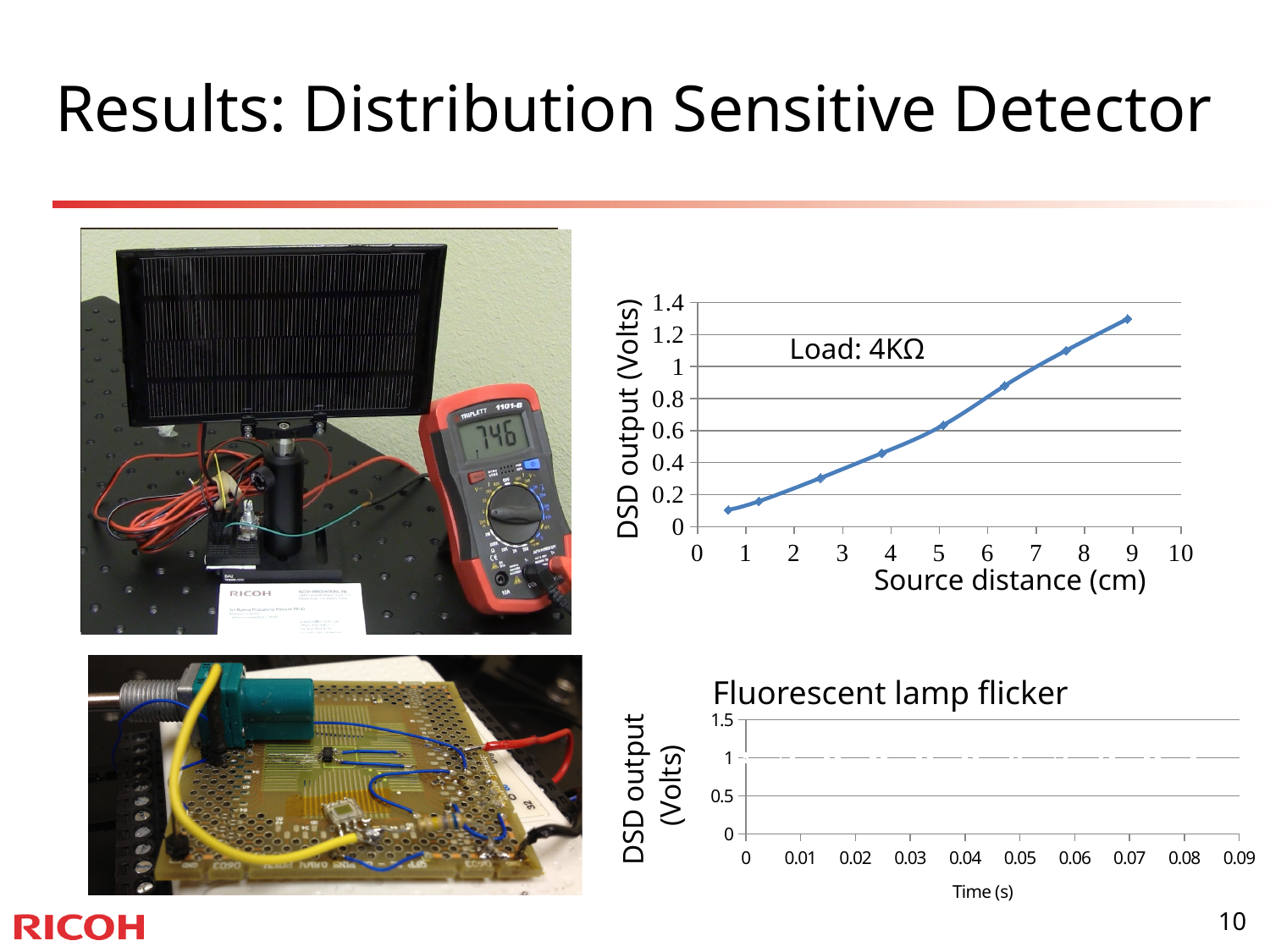
In the top-right chart, is the DSD output at the farthest source distance (about 9 cm) greater or less than 1.2 Volts? greater What load resistance is annotated on the top-right chart? 4KΩ What is the title of the bottom-right chart? Fluorescent lamp flicker What kind of chart is the top-right chart of DSD output versus source distance? line chart In the top-right chart, is the DSD output at the closest source distance (under 1 cm) greater or less than 0.2 Volts? less How many data points are plotted in the top-right chart of DSD output versus source distance? 8 In the top-right chart, is the DSD output at a source distance of about 2.5 cm greater or less than 0.4 Volts? less In the top-right chart, does the DSD output rise or fall as the source distance increases? rises